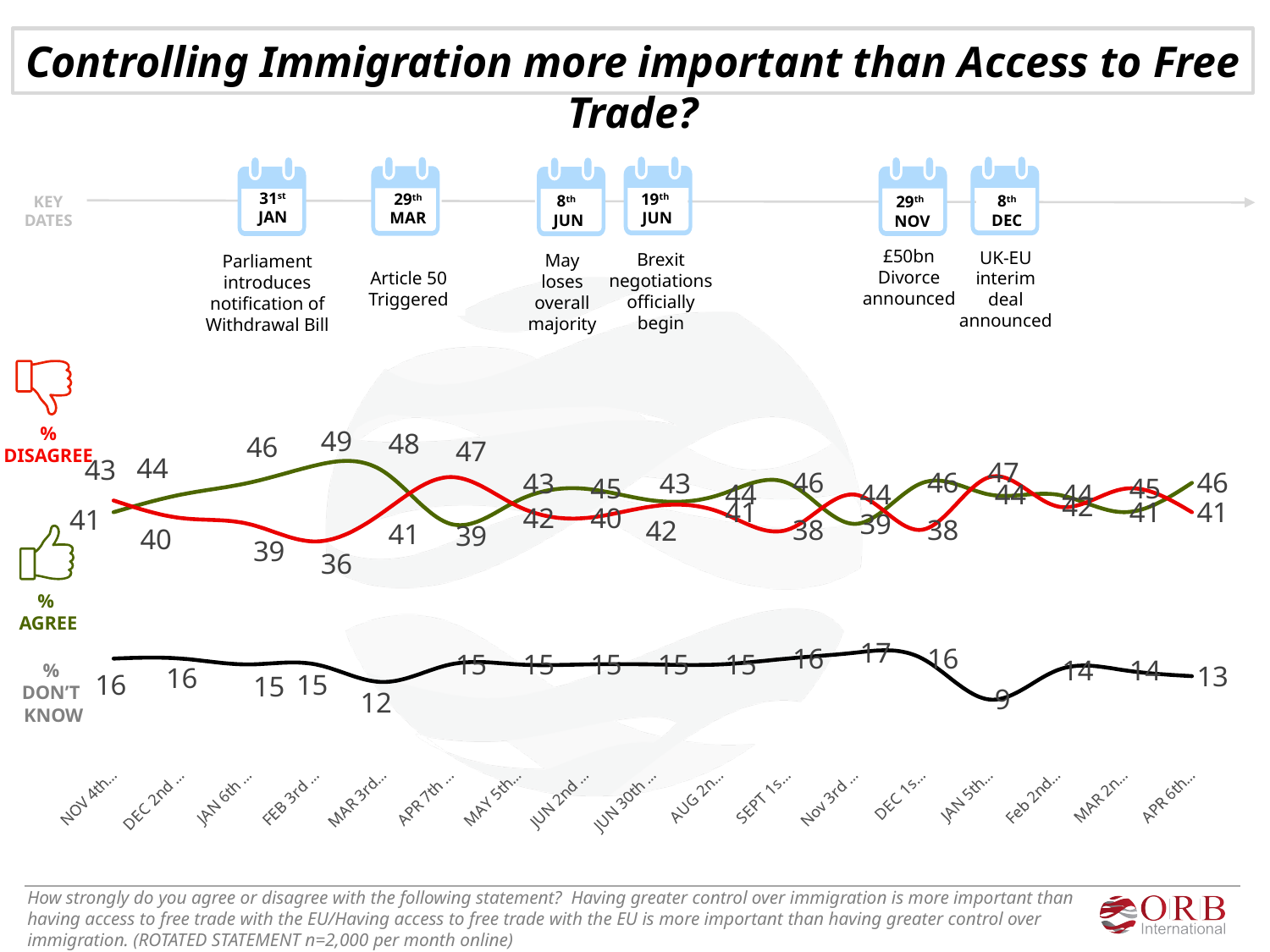
What colour is the % Disagree line? red What is the % Disagree value at FEB 3rd? 36 What is the difference between % Agree and % Disagree at FEB 3rd? 13 What is the % Agree value at FEB 3rd? 49 How many survey dates (points) are plotted along the x axis? 17 What is the % Don't Know value at MAR 3rd? 12 At which date is the % Don't Know value lowest? JAN 5th What kind of chart is shown on the slide? line chart How many series (lines) are plotted on the chart? 3 What is the % Don't Know value at JAN 5th? 9 At SEPT 1st, which is larger: % Agree or % Disagree? % Agree At which date is the % Don't Know value highest? Nov 3rd